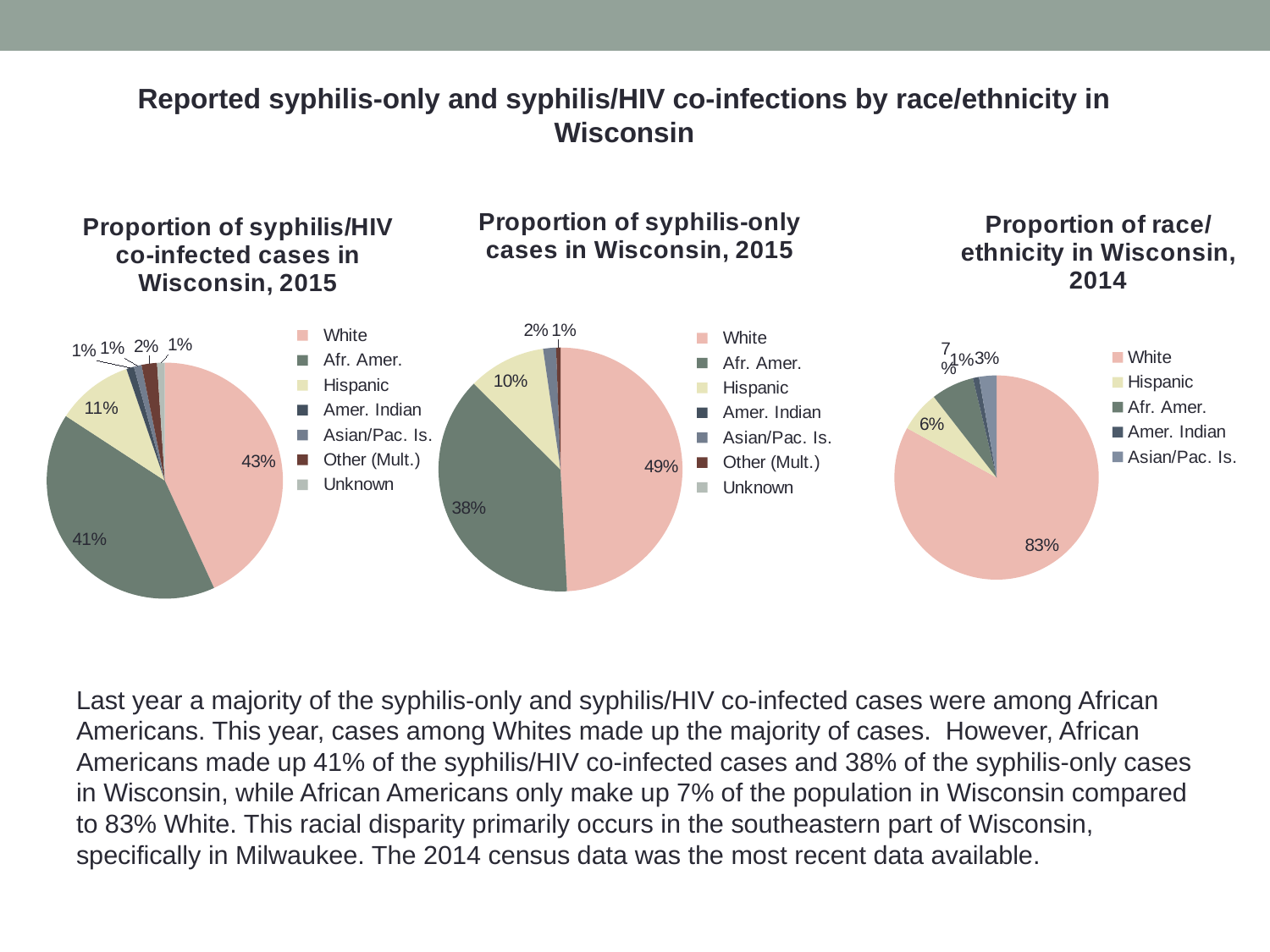
In the 'Proportion of race/ethnicity in Wisconsin, 2014' chart, what share of the population is Afr. Amer.? 7% What type of chart is used for the 'Proportion of syphilis/HIV co-infected cases in Wisconsin, 2015' chart? Pie chart In the 'Proportion of race/ethnicity in Wisconsin, 2014' chart, what share of the population is White? 83% In the 'Proportion of syphilis/HIV co-infected cases in Wisconsin, 2015' chart, what share of cases is White? 43% How many groups does the legend of the 'Proportion of race/ethnicity in Wisconsin, 2014' chart list? 5 In the 'Proportion of syphilis-only cases in Wisconsin, 2015' chart, what share of cases is Hispanic? 10% In the 'Proportion of syphilis-only cases in Wisconsin, 2015' chart, what share of cases is White? 49% In the 'Proportion of syphilis-only cases in Wisconsin, 2015' chart, how many percentage points larger is the White share than the Afr. Amer. share? 11 percentage points In the 'Proportion of syphilis/HIV co-infected cases in Wisconsin, 2015' chart, what share of cases is Hispanic? 11% In the 'Proportion of syphilis-only cases in Wisconsin, 2015' chart, which group has the largest slice? White In the 'Proportion of syphilis/HIV co-infected cases in Wisconsin, 2015' chart, what share of cases is Afr. Amer.? 41% In the 'Proportion of syphilis-only cases in Wisconsin, 2015' chart, what share of cases is Afr. Amer.? 38%